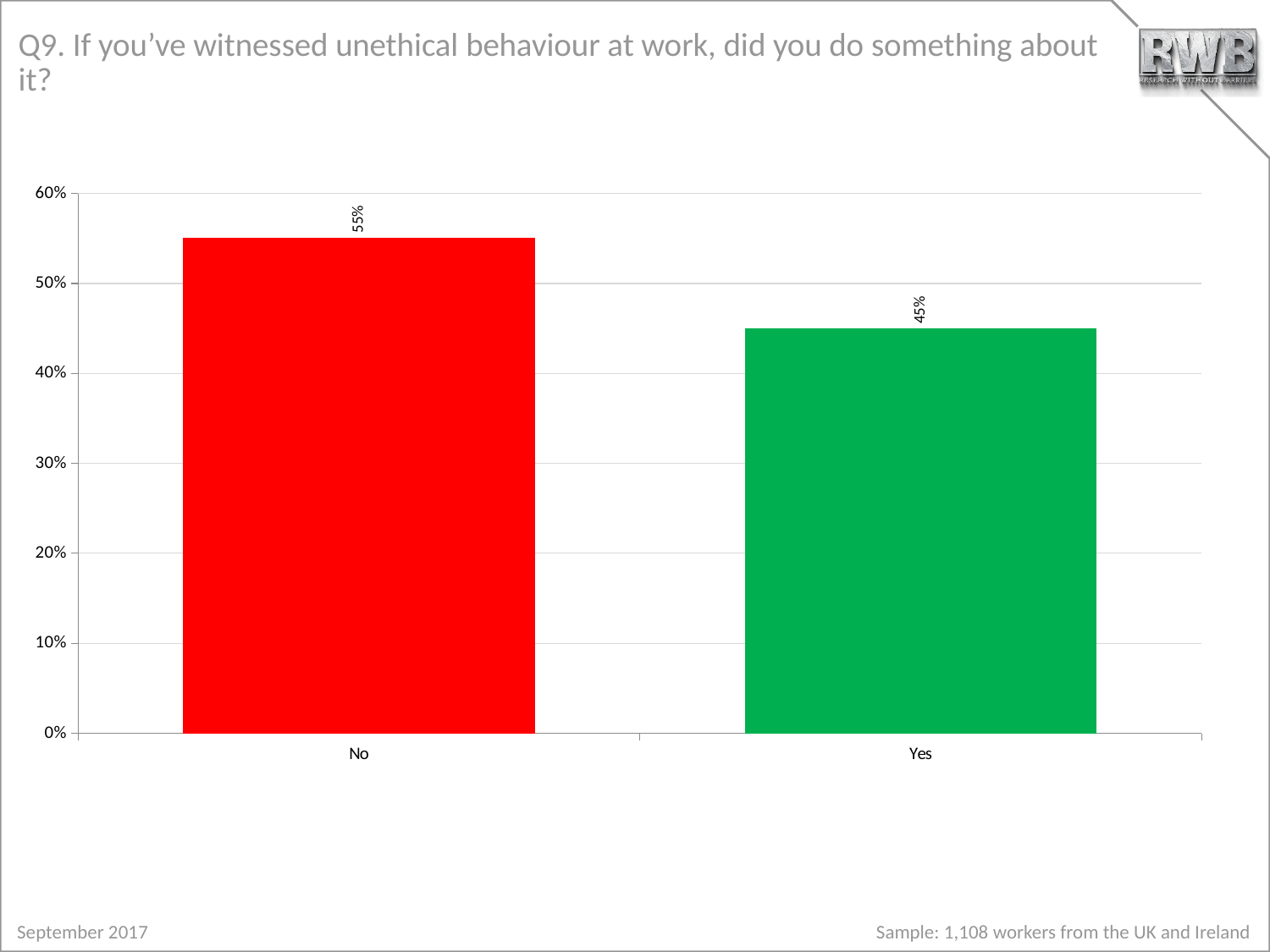
What is the value for Yes? 45% What is the difference between the values for No and Yes? 10% Is the value for No greater or less than 50%? greater What is the highest value shown on the y axis? 60% Which category has the lowest value? Yes What kind of chart is shown on the slide? bar chart Which is larger, the value for No or the value for Yes? No What colour is the bar for No? red How many categories are shown on the x axis? 2 What is the value for No? 55% Which category has the highest value? No Is the value for Yes greater or less than 50%? less